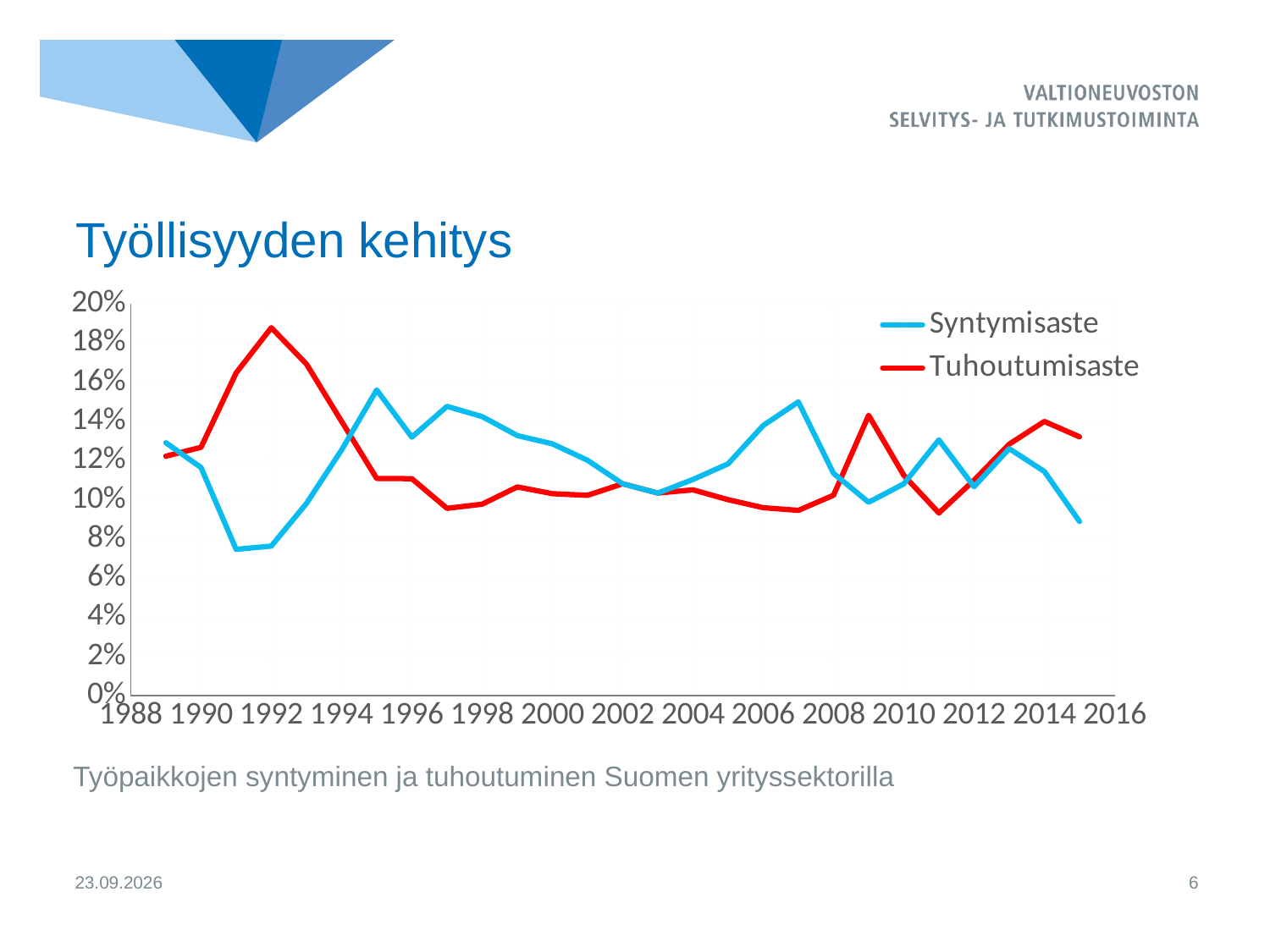
In which year does Tuhoutumisaste reach its highest value? 1992 Is the value of Syntymisaste in 1991 greater or less than 8%? less Is the value of Syntymisaste in 2015 greater or less than 10%? less Is the value of Tuhoutumisaste in 2009 greater or less than 12%? greater How many series does the legend list? 2 In 2007, which series has the larger value, Syntymisaste or Tuhoutumisaste? Syntymisaste What kind of chart is shown on the slide? line chart In 1992, which series has the larger value, Syntymisaste or Tuhoutumisaste? Tuhoutumisaste What colour is the Syntymisaste line? blue Does Syntymisaste rise or fall between 2013 and 2015? fall